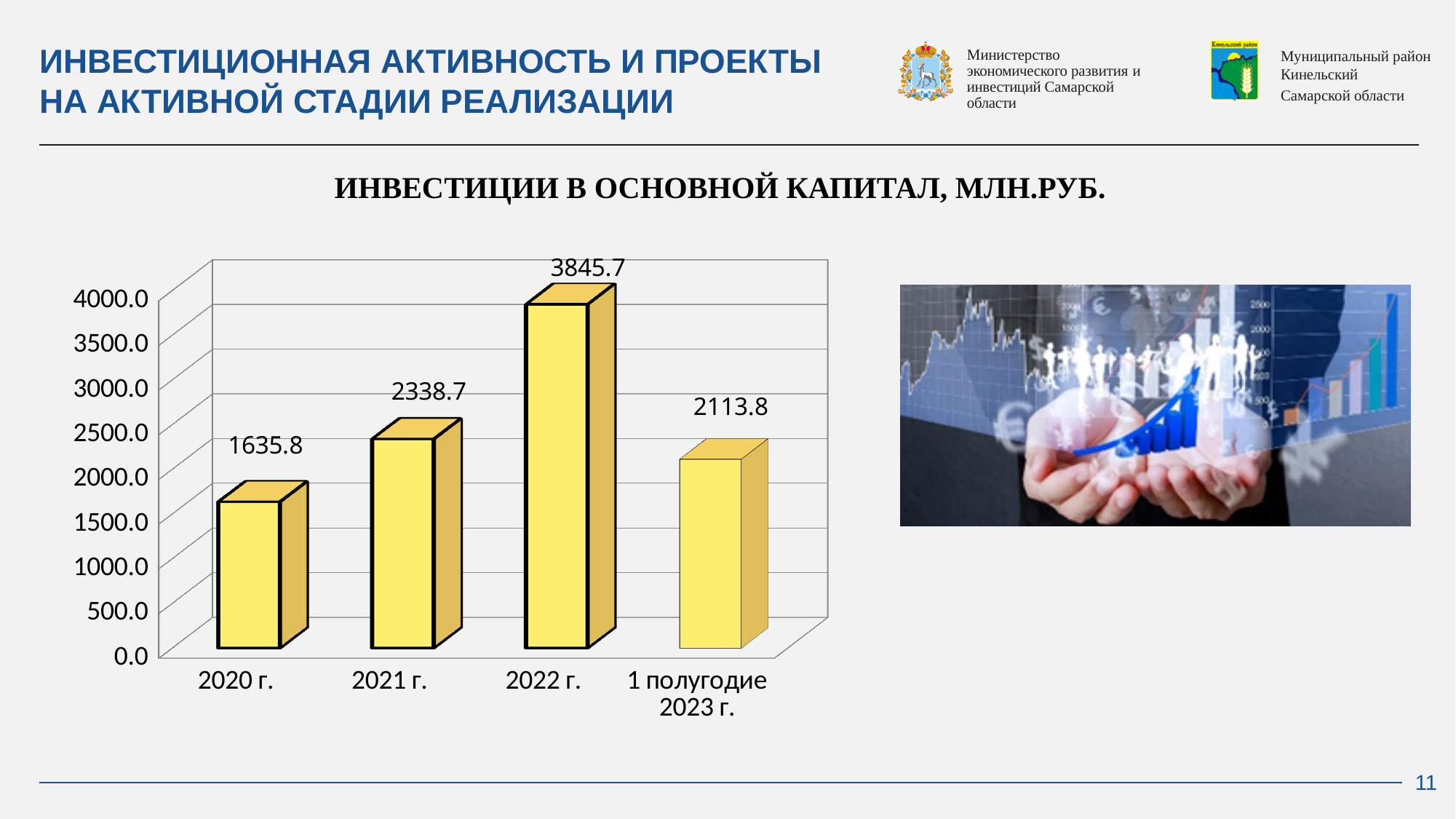
How many categories are shown on the chart? 4 Which is larger, the value for 2021 г. or the value for 1 полугодие 2023 г.? 2021 г. What kind of chart is shown on the slide? Bar chart What is the difference between the values for 2021 г. and 2020 г.? 702.9 What is the value for 2020 г.? 1635.8 What is the value for 2022 г.? 3845.7 Which category has the highest value? 2022 г. What is the difference between the values for 2022 г. and 2021 г.? 1507.0 What is the title of the chart? ИНВЕСТИЦИИ В ОСНОВНОЙ КАПИТАЛ, МЛН.РУБ. Which category has the lowest value? 2020 г. What is the value for 2021 г.? 2338.7 What is the value for 1 полугодие 2023 г.? 2113.8